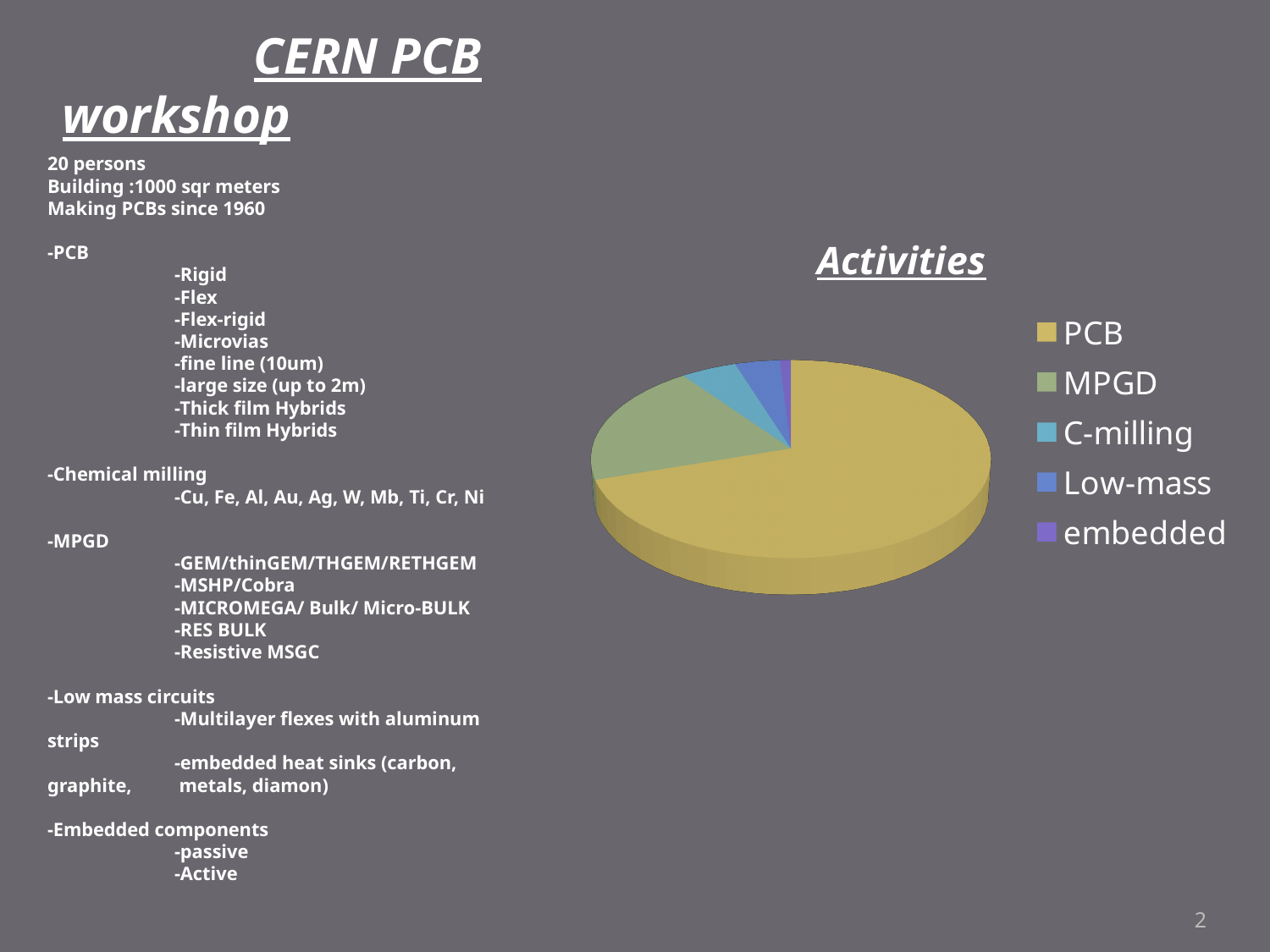
In the "Activities" pie chart, which slice is larger, PCB or MPGD? PCB Which category has the smallest slice in the "Activities" pie chart? embedded What kind of chart is shown under the title "Activities"? pie chart In the "Activities" pie chart, which slice is larger, Low-mass or embedded? Low-mass How many categories does the "Activities" pie chart show? 5 Which category has the largest slice in the "Activities" pie chart? PCB What colour is the PCB slice in the "Activities" pie chart? yellow In the "Activities" pie chart, which slice is larger, MPGD or C-milling? MPGD What is the title of the pie chart on the slide? Activities How many entries does the legend of the "Activities" chart list? 5